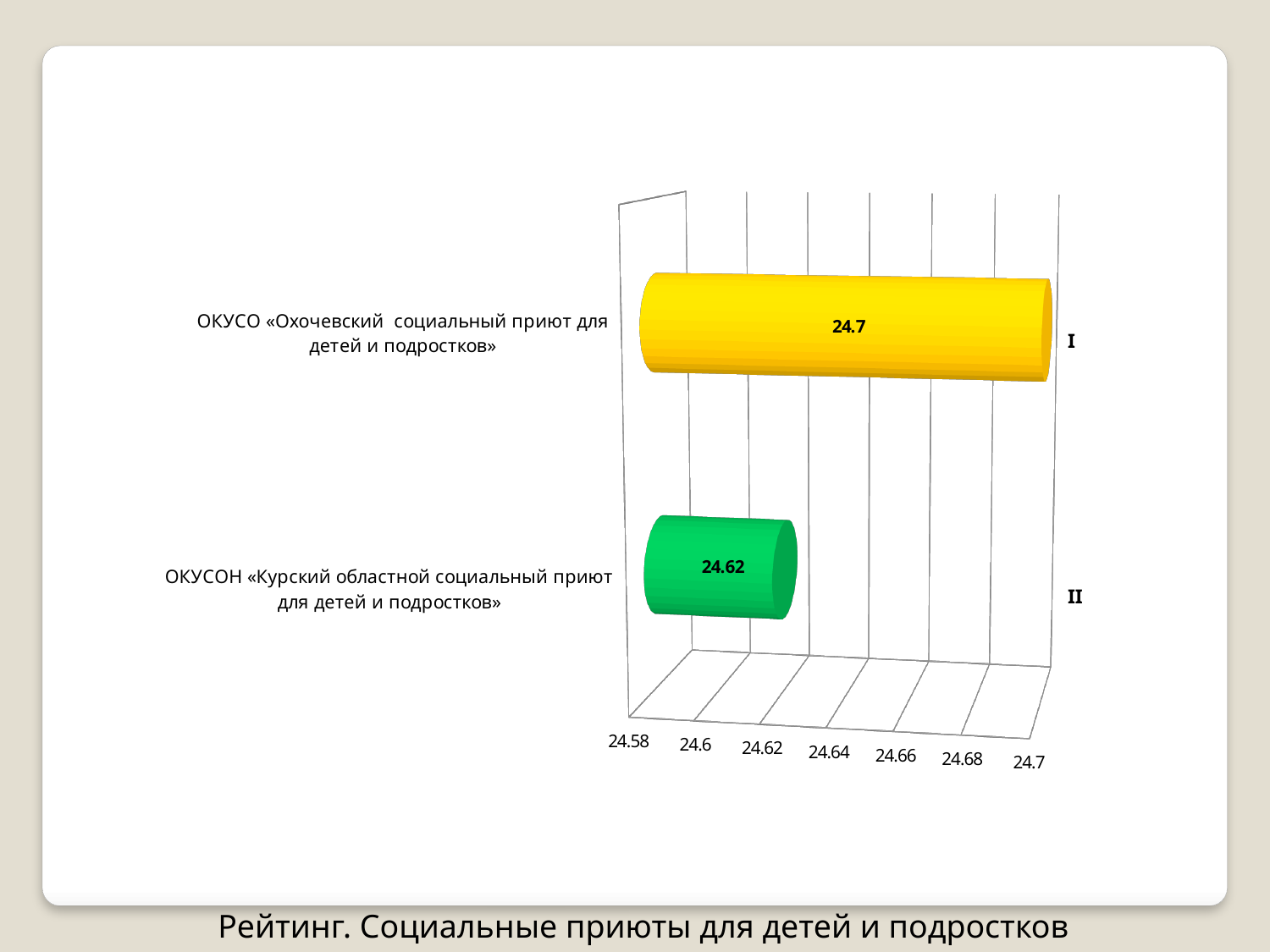
How many categories are shown in the chart? 2 Which is larger: the value for ОКУСО «Охочевский социальный приют для детей и подростков» or for ОКУСОН «Курский областной социальный приют для детей и подростков»? ОКУСО «Охочевский социальный приют для детей и подростков» What rank label is shown next to the bar for ОКУСО «Охочевский социальный приют для детей и подростков»? I What is the title text at the bottom of the slide? Рейтинг. Социальные приюты для детей и подростков What kind of chart is shown on the slide? bar chart Which category has the lowest value? ОКУСОН «Курский областной социальный приют для детей и подростков» What is the value for ОКУСО «Охочевский социальный приют для детей и подростков»? 24.7 Is the value for ОКУСО «Охочевский социальный приют для детей и подростков» greater or less than 24.64? greater What is the difference between the values for ОКУСО «Охочевский социальный приют для детей и подростков» and ОКУСОН «Курский областной социальный приют для детей и подростков»? 0.08 What is the value for ОКУСОН «Курский областной социальный приют для детей и подростков»? 24.62 Which category has the highest value? ОКУСО «Охочевский социальный приют для детей и подростков» Is the value for ОКУСОН «Курский областной социальный приют для детей и подростков» greater or less than 24.66? less